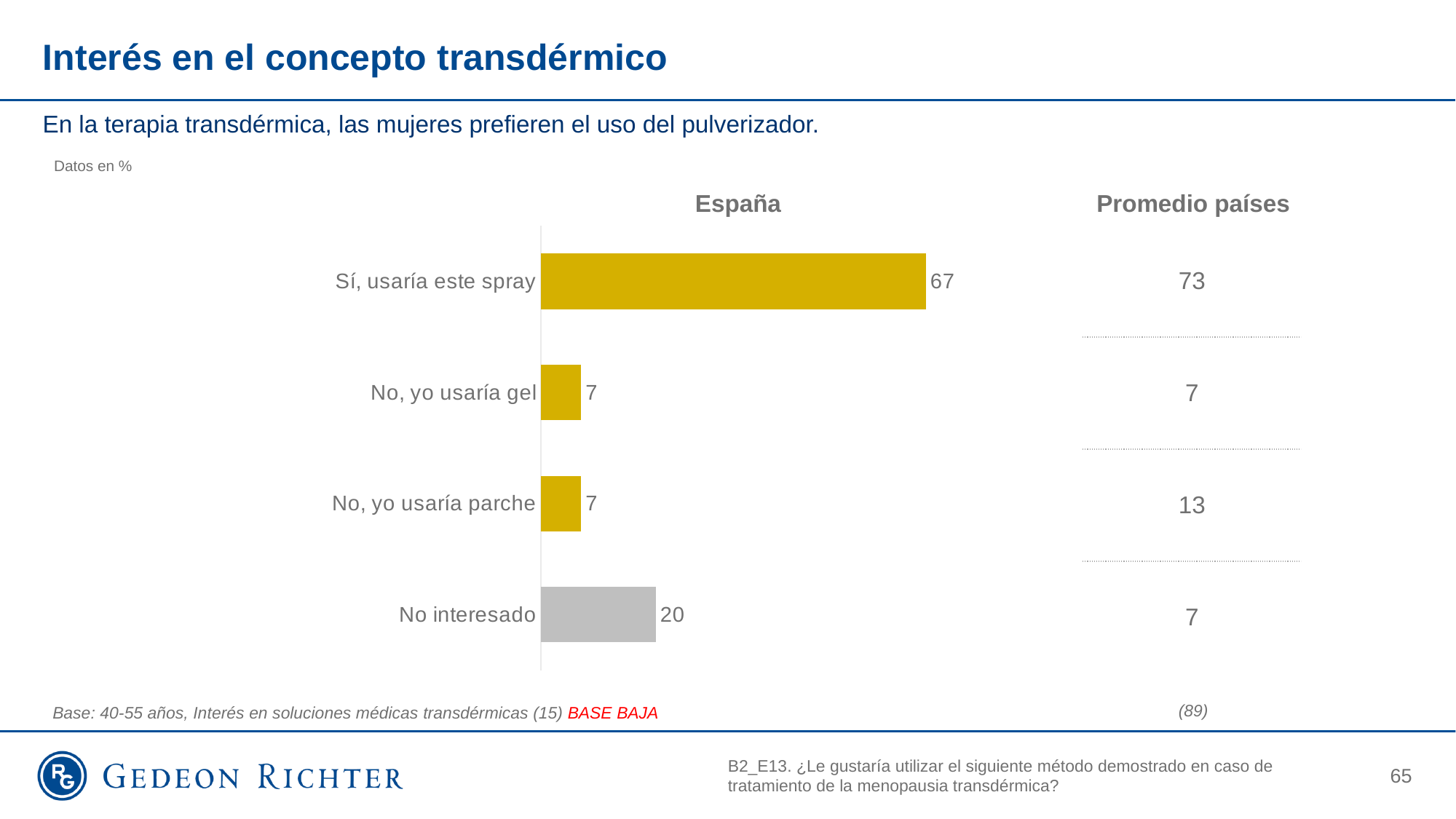
What is the "Promedio países" value for "Sí, usaría este spray"? 73 What kind of chart is used to show the España data? Bar chart What is the "Promedio países" value for "No, yo usaría parche"? 13 Which category has the highest value in the España bar chart? Sí, usaría este spray How many categories are shown in the España bar chart? 4 What is the difference between "Sí, usaría este spray" and "No interesado" in the España bar chart? 47 Which bar in the España chart is coloured grey rather than yellow? No interesado What is the value for "No, yo usaría gel" in the España bar chart? 7 What is the difference between the España value and the Promedio países value for "No interesado"? 13 What is the value for "Sí, usaría este spray" in the España bar chart? 67 In the España bar chart, which is larger: "No interesado" or "No, yo usaría parche"? No interesado What is the value for "No interesado" in the España bar chart? 20